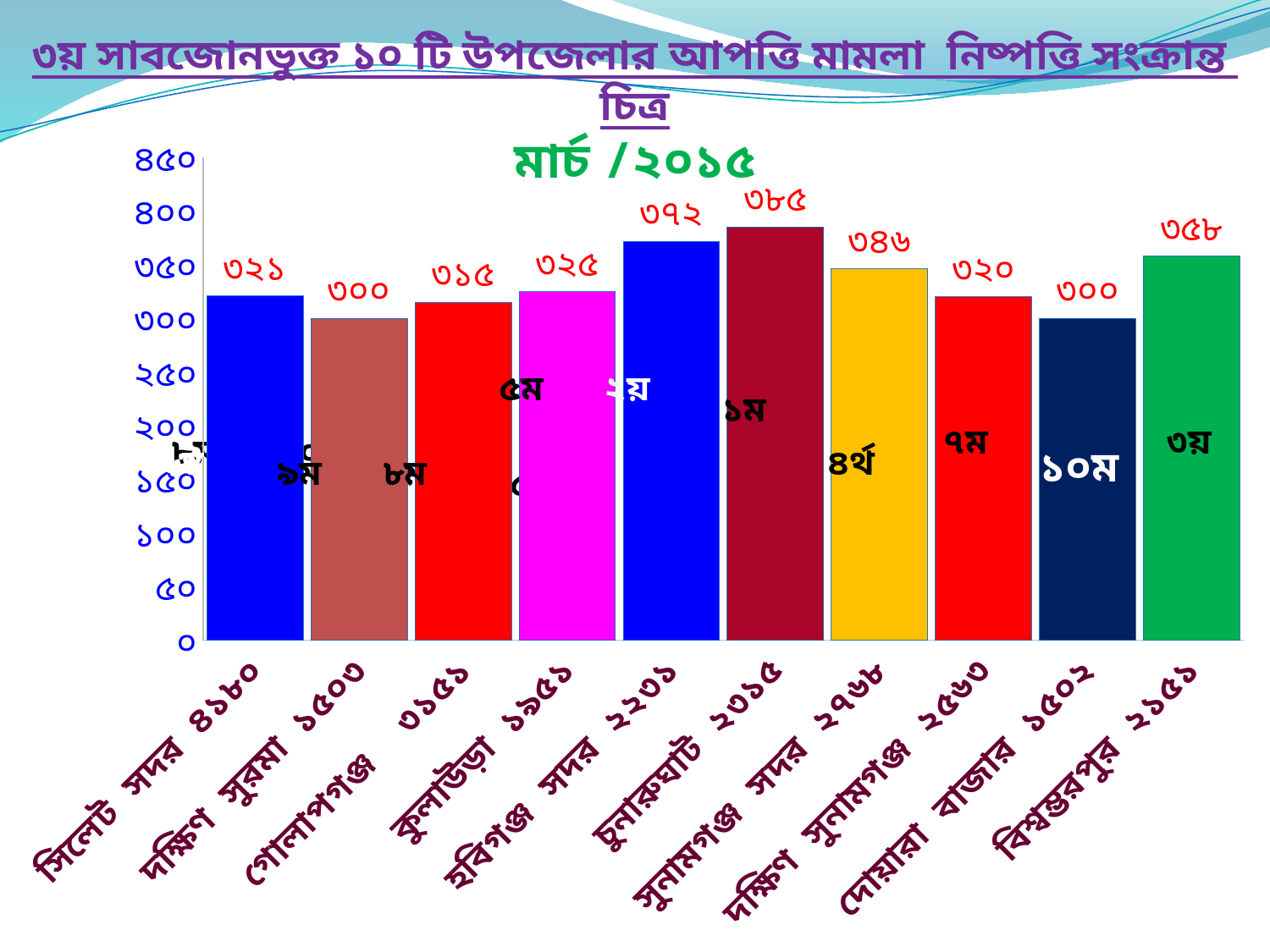
Which is larger, the value for সিলেট সদর ৪১৮০ or the value for কুলাউড়া ১৯৫১? কুলাউড়া ১৯৫১ What is the title of the chart? মার্চ /২০১৫ What is the value shown for বিশ্বম্ভরপুর ২১৫১? ৩৫৮ What is the value shown for চুনারুঘাট ২৩১৫? ৩৮৫ How many categories (bars) are shown in the chart? 10 What is the difference between the values for চুনারুঘাট ২৩১৫ and হবিগঞ্জ সদর ২২৩১? ১৩ Which category has the highest value? চুনারুঘাট ২৩১৫ What kind of chart is shown on the slide? bar chart Is the value for দোয়ারা বাজার ১৫০২ greater or less than ৩৫০? less What is the value shown for হবিগঞ্জ সদর ২২৩১? ৩৭২ What is the value shown for সুনামগঞ্জ সদর ২৭৬৮? ৩৪৬ Which rank label is printed on the bar for চুনারুঘাট ২৩১৫? ১ম